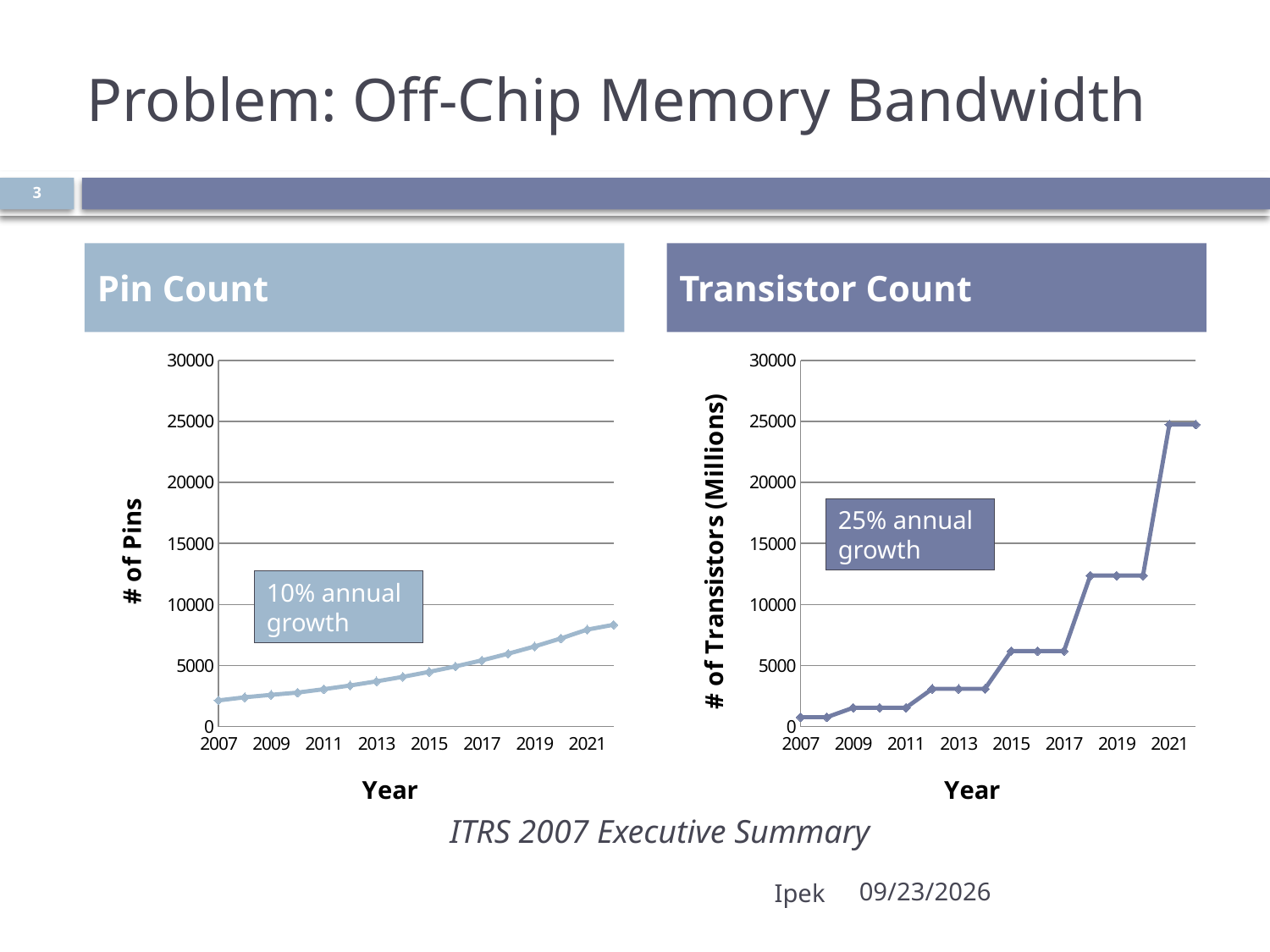
In the Pin Count chart, is the value for 2022 greater or less than 10000? less In the Pin Count chart, is the value for 2007 greater or less than 5000? less What is the y-axis title of the Pin Count chart? # of Pins What kind of chart is the Pin Count chart? line chart In the Transistor Count chart, which year has the lowest value? 2007 and 2008 What annual growth rate is annotated on the Transistor Count chart? 25% annual growth In the Transistor Count chart, do the values rise or fall along the x axis? rise In the Transistor Count chart, is the value for 2022 greater or less than 20000? greater In the Pin Count chart, do the values rise or fall from 2007 to 2022? rise In the Pin Count chart, which year has the highest value? 2022 What kind of chart is the Transistor Count chart? line chart